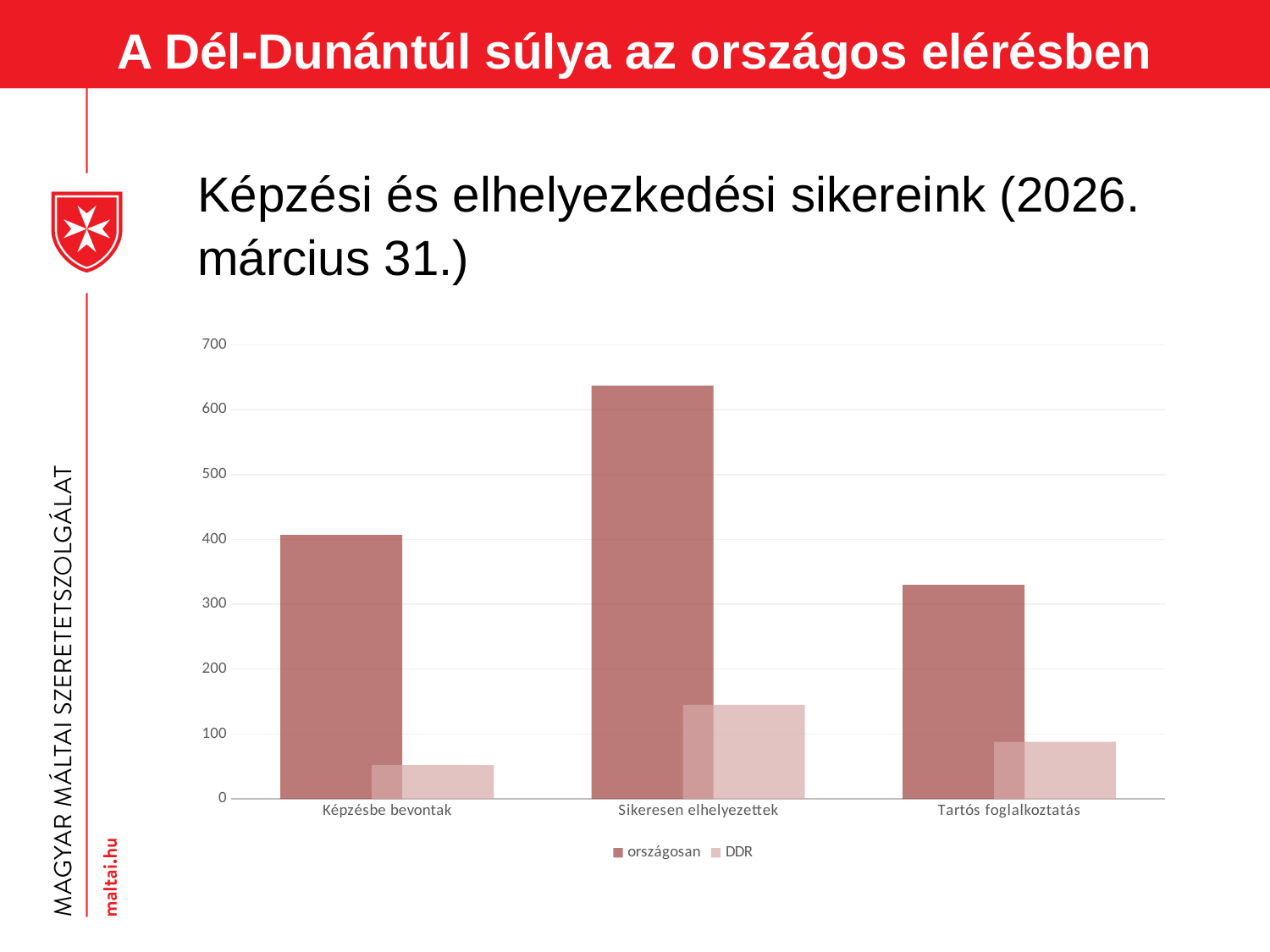
How many categories are shown on the x axis? 3 How many series does the legend list? 2 What kind of chart is shown on the slide? bar chart Which category has the lowest value for the 'DDR' series? Képzésbe bevontak Which is larger: the 'DDR' value for Sikeresen elhelyezettek or the 'DDR' value for Tartós foglalkoztatás? Sikeresen elhelyezettek Is the 'országosan' value for Tartós foglalkoztatás greater or less than 300? greater Which category has the lowest value for the 'országosan' series? Tartós foglalkoztatás Which category has the highest value for the 'országosan' series? Sikeresen elhelyezettek Is the 'DDR' value for Képzésbe bevontak greater or less than 100? less Which is larger for Képzésbe bevontak: the 'országosan' value or the 'DDR' value? országosan Is the 'országosan' value for Sikeresen elhelyezettek greater or less than 600? greater What are the two series names listed in the legend? országosan and DDR